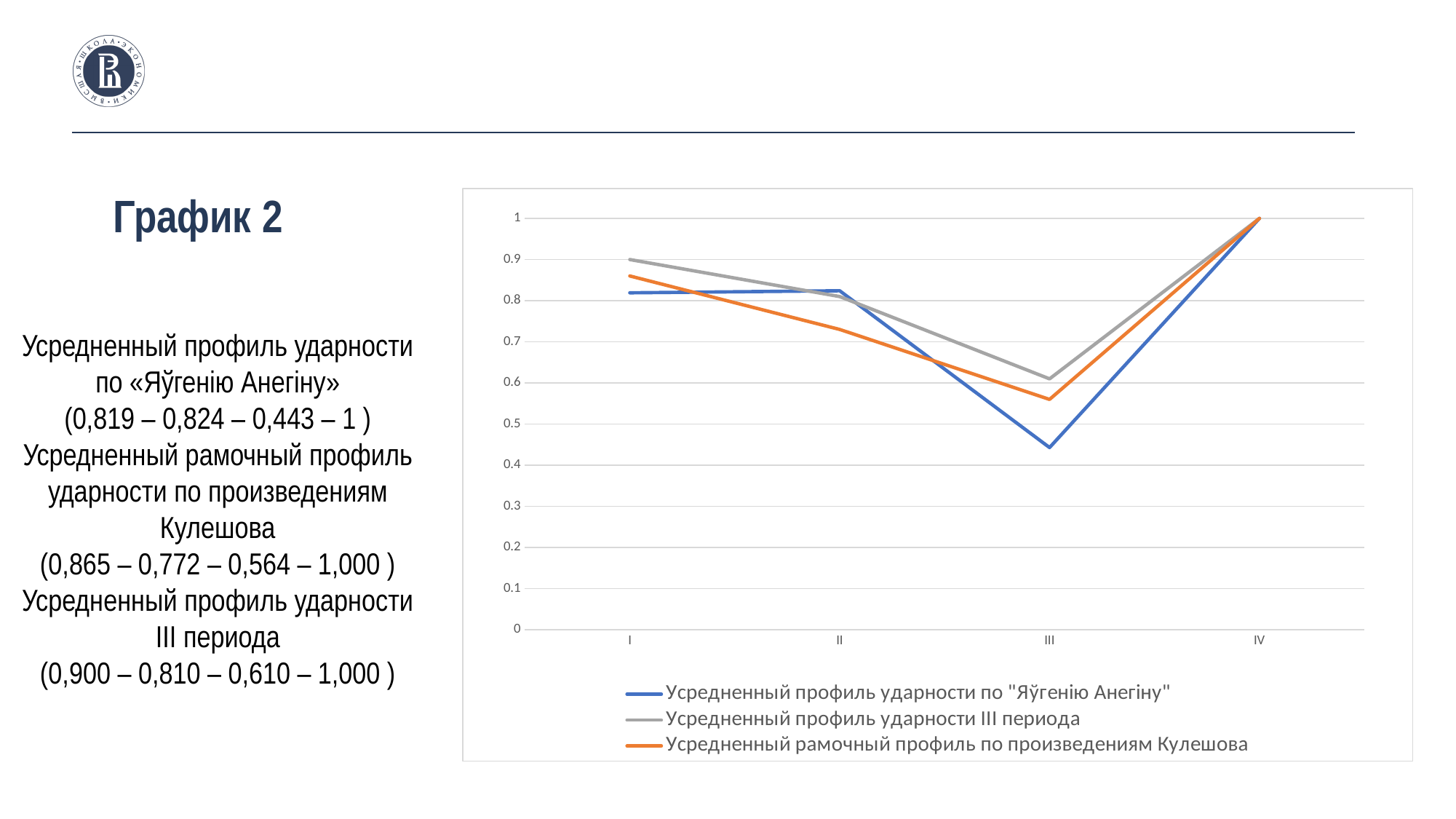
What colour is the line for the Кулешова series? orange How many points are on the x axis of the chart? 4 What value do all three series reach at point IV? 1 Is the value of the "Яўгенію Анегіну" series at point III greater or less than 0.5? less What kind of chart is shown on the slide? line chart At point II, which is larger: the "Яўгенію Анегіну" series or the Кулешова series? Яўгенію Анегіну Do the values of the "III периода" series rise or fall from point I to point III? fall Is the value of the Кулешова series at point II greater or less than 0.8? less Which series has the highest value at point I? Усредненный профиль ударности III периода Which series has the lowest value at point III? Усредненный профиль ударности по "Яўгенію Анегіну" How many series does the chart legend list? 3